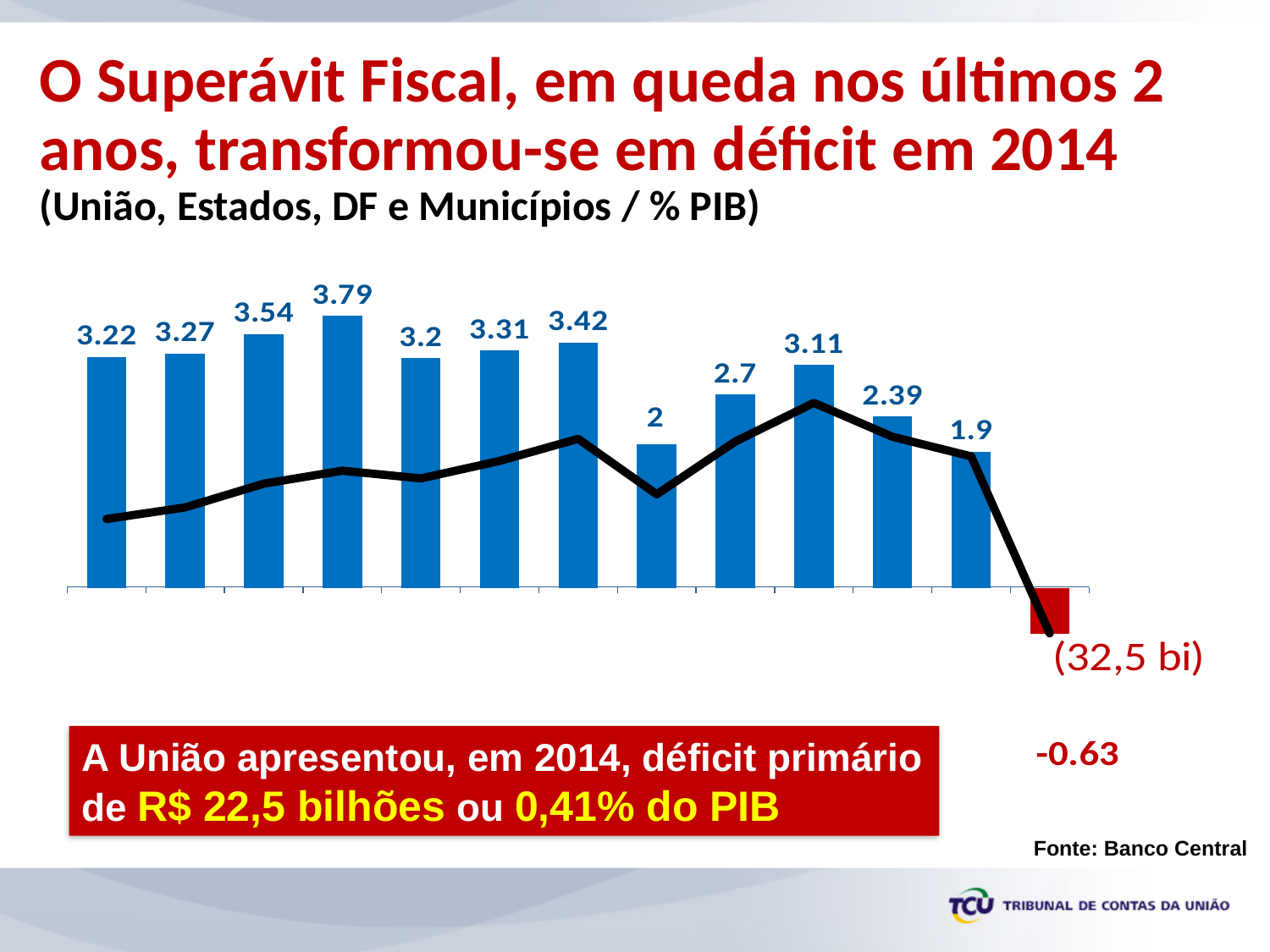
What kind of chart is shown on the slide? combination bar and line chart What is the lowest value labelled on any bar in the chart? -0.63 How many bars are plotted in the chart? 13 Do the bar values rise or fall over the last four bars of the chart? fall What is the highest value labelled on any bar in the chart? 3.79 What colour is the only bar with a negative value? red What is the value labelled on the last (rightmost, red) bar? -0.63 What is the difference between the second-to-last bar (1.9) and the last bar (-0.63)? 2.53 What is the value labelled on the first (leftmost) bar? 3.22 What is the difference between the highest bar value (3.79) and the first bar value (3.22)? 0.57 Which is larger, the value of the tenth bar (3.11) or the value of the eleventh bar (2.39)? 3.11 What is the value labelled on the eighth bar from the left? 2